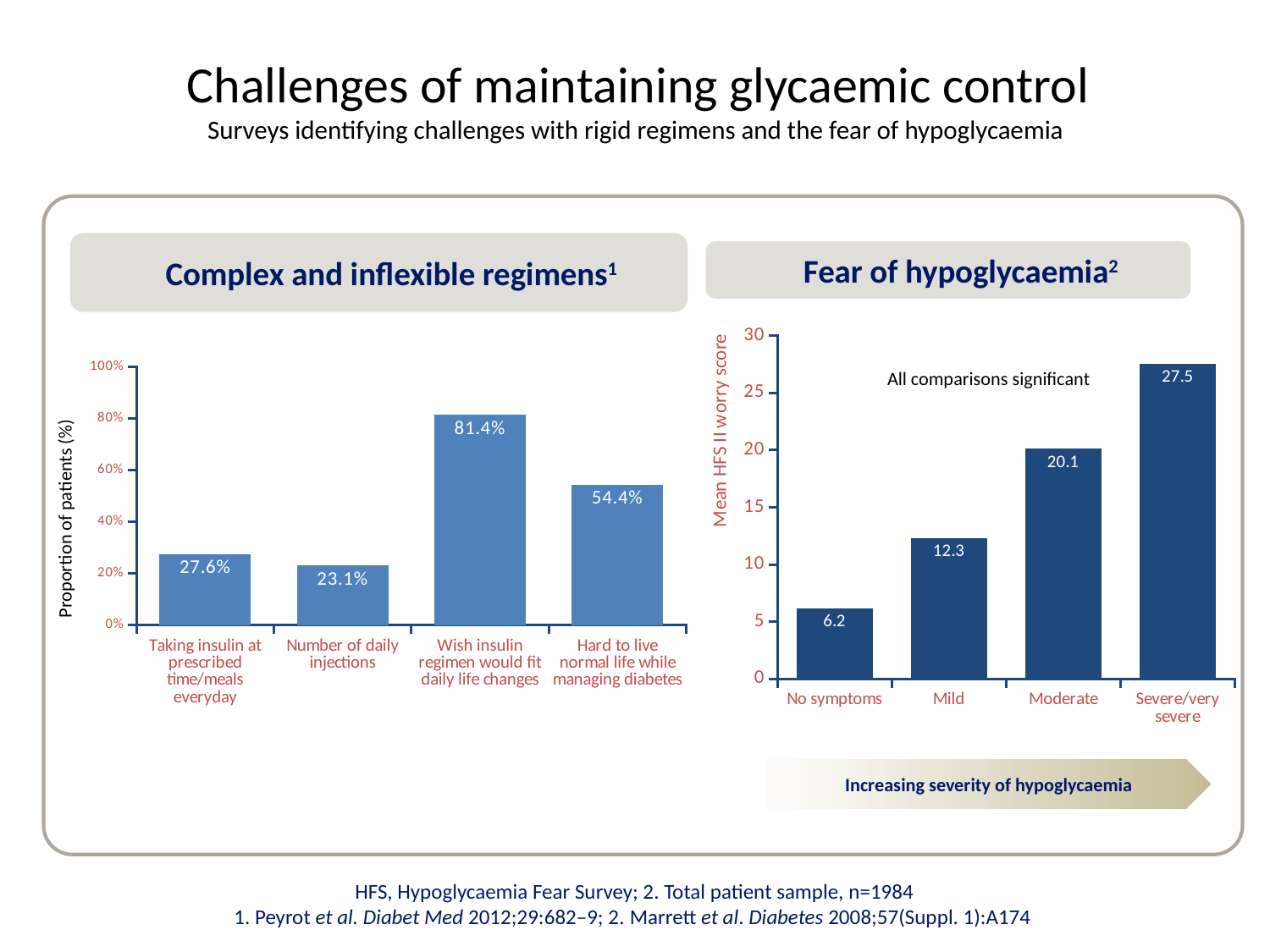
What type of chart is the 'Fear of hypoglycaemia' chart? bar chart In the 'Complex and inflexible regimens' chart, how many categories are shown? 4 In the 'Fear of hypoglycaemia' chart, what is the mean HFS II worry score for 'No symptoms'? 6.2 In the 'Fear of hypoglycaemia' chart, do the worry scores rise or fall as severity increases along the x axis? rise In the 'Fear of hypoglycaemia' chart, what is the difference in mean worry score between 'Severe/very severe' and 'Mild'? 15.2 In the 'Complex and inflexible regimens' chart, what proportion of patients said they wish their insulin regimen would fit daily life changes? 81.4% In the 'Complex and inflexible regimens' chart, which category has the lowest proportion of patients? Number of daily injections In the 'Complex and inflexible regimens' chart, what is the value for 'Number of daily injections'? 23.1% In the 'Complex and inflexible regimens' chart, what is the difference between 'Hard to live normal life while managing diabetes' and 'Taking insulin at prescribed time/meals everyday'? 26.8% In the 'Complex and inflexible regimens' chart, which category has the highest proportion of patients? Wish insulin regimen would fit daily life changes In the 'Fear of hypoglycaemia' chart, which group has the highest mean HFS II worry score? Severe/very severe In the 'Fear of hypoglycaemia' chart, what is the mean HFS II worry score for the 'Moderate' group? 20.1